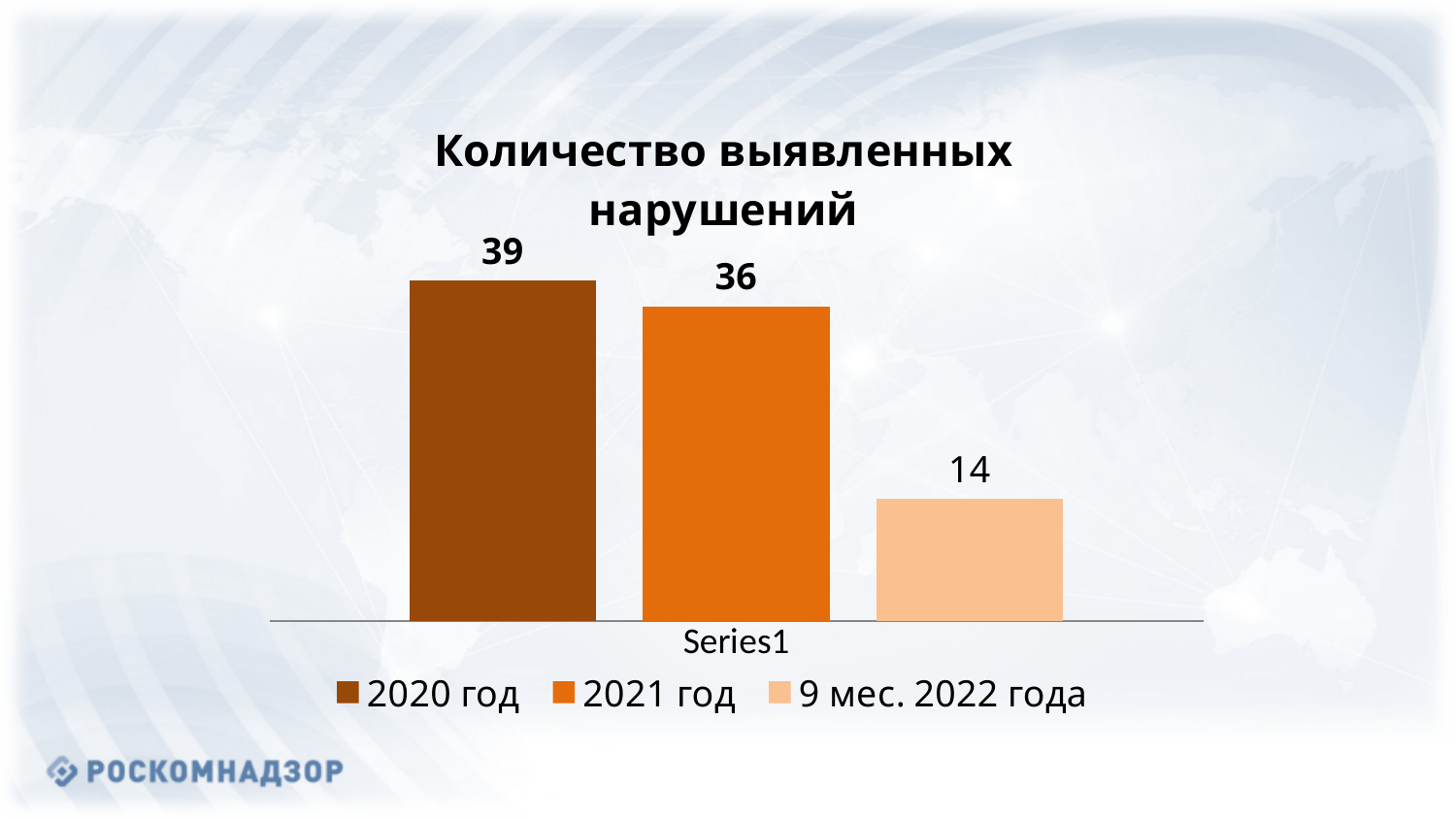
What kind of chart is shown on the slide? bar chart What is the value for 9 мес. 2022 года? 14 What is the value for 2020 год? 39 What is the value for 2021 год? 36 What is the title of the chart? Количество выявленных нарушений What is the difference between the values for 2020 год and 2021 год? 3 Which is larger, the value for 2021 год or the value for 9 мес. 2022 года? 2021 год What is the difference between the values for 2021 год and 9 мес. 2022 года? 22 How many series does the legend list? 3 Which series has the lowest value? 9 мес. 2022 года Do the values rise or fall from 2020 год to 9 мес. 2022 года? fall Which series has the highest value? 2020 год